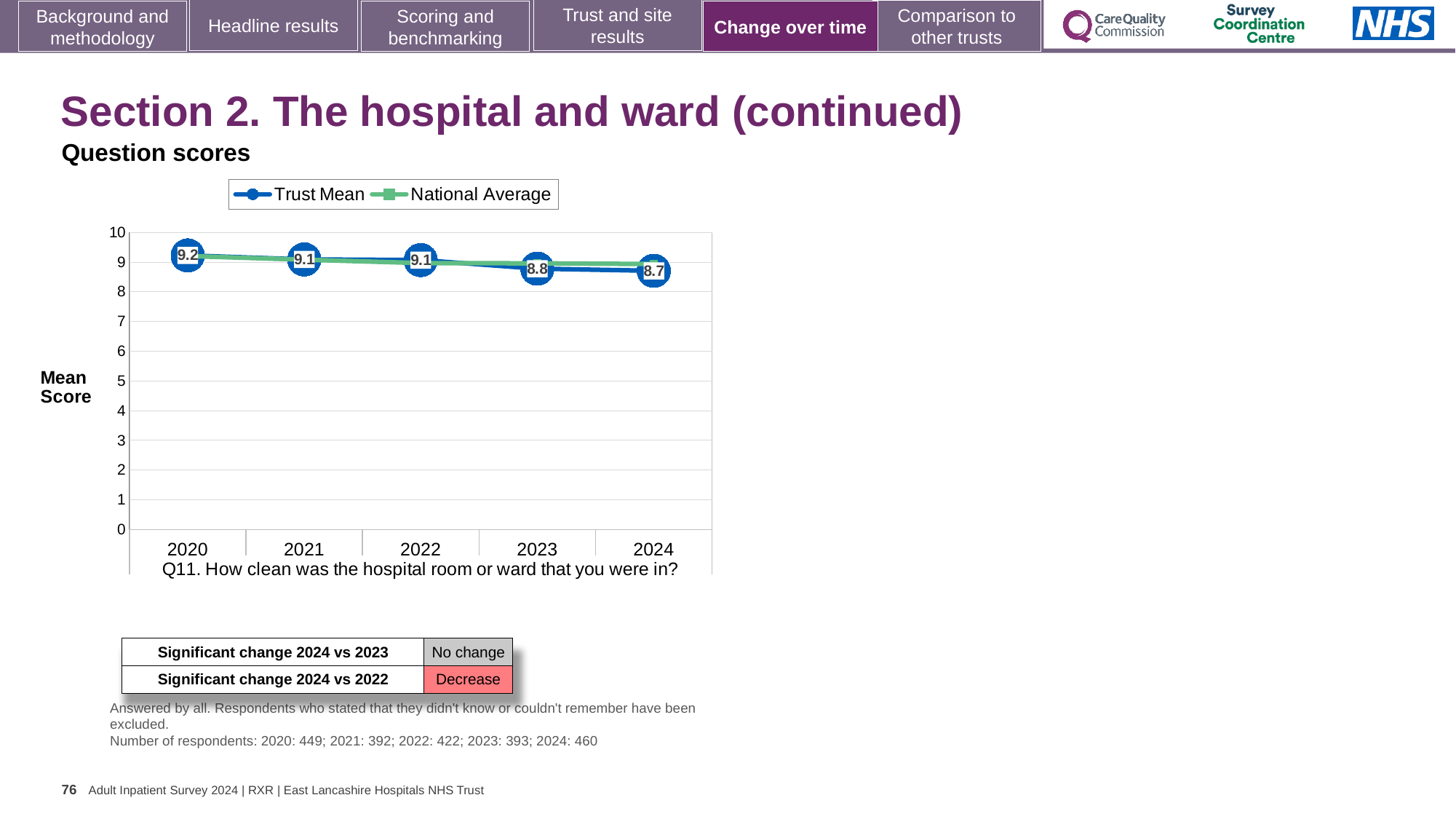
Which year has the lowest Trust Mean? 2024 How many series does the legend list? 2 What is the Trust Mean for 2020? 9.2 What is the Trust Mean for 2024? 8.7 Does the Trust Mean rise or fall from 2020 to 2024? fall What is the difference between the Trust Mean in 2020 and in 2024? 0.5 Which year has the highest Trust Mean? 2020 How many years are shown on the x axis? 5 What kind of chart is shown? line chart Is the National Average for 2024 greater or less than 8? greater Is the Trust Mean higher in 2021 or in 2023? 2021 What is the Trust Mean for 2023? 8.8